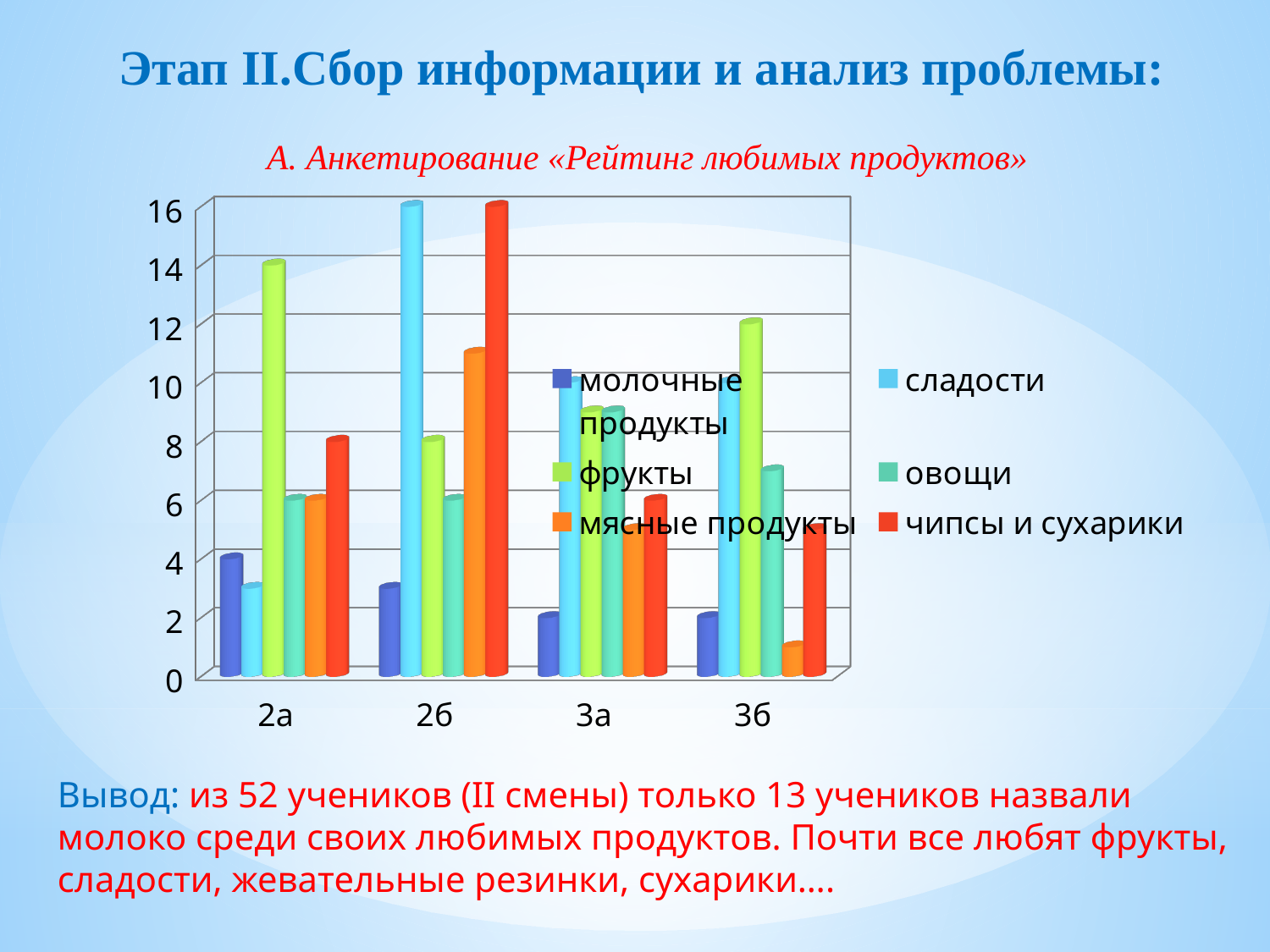
Which series has the highest value for class 2а? фрукты What is the name of the survey shown above the chart? Рейтинг любимых продуктов Is the value for молочные продукты in class 3а greater or less than 4? less Which series has the lowest value for class 3б? мясные продукты What kind of chart is shown on the slide? bar chart How many class categories are shown on the x axis of the chart? 4 Which series has the highest value for class 3б? фрукты How many series does the chart legend list? 6 Is the value for фрукты in class 2а greater or less than 12? greater Is the value for мясные продукты in class 2б greater or less than 10? greater For class 2б, which is larger: сладости or молочные продукты? сладости